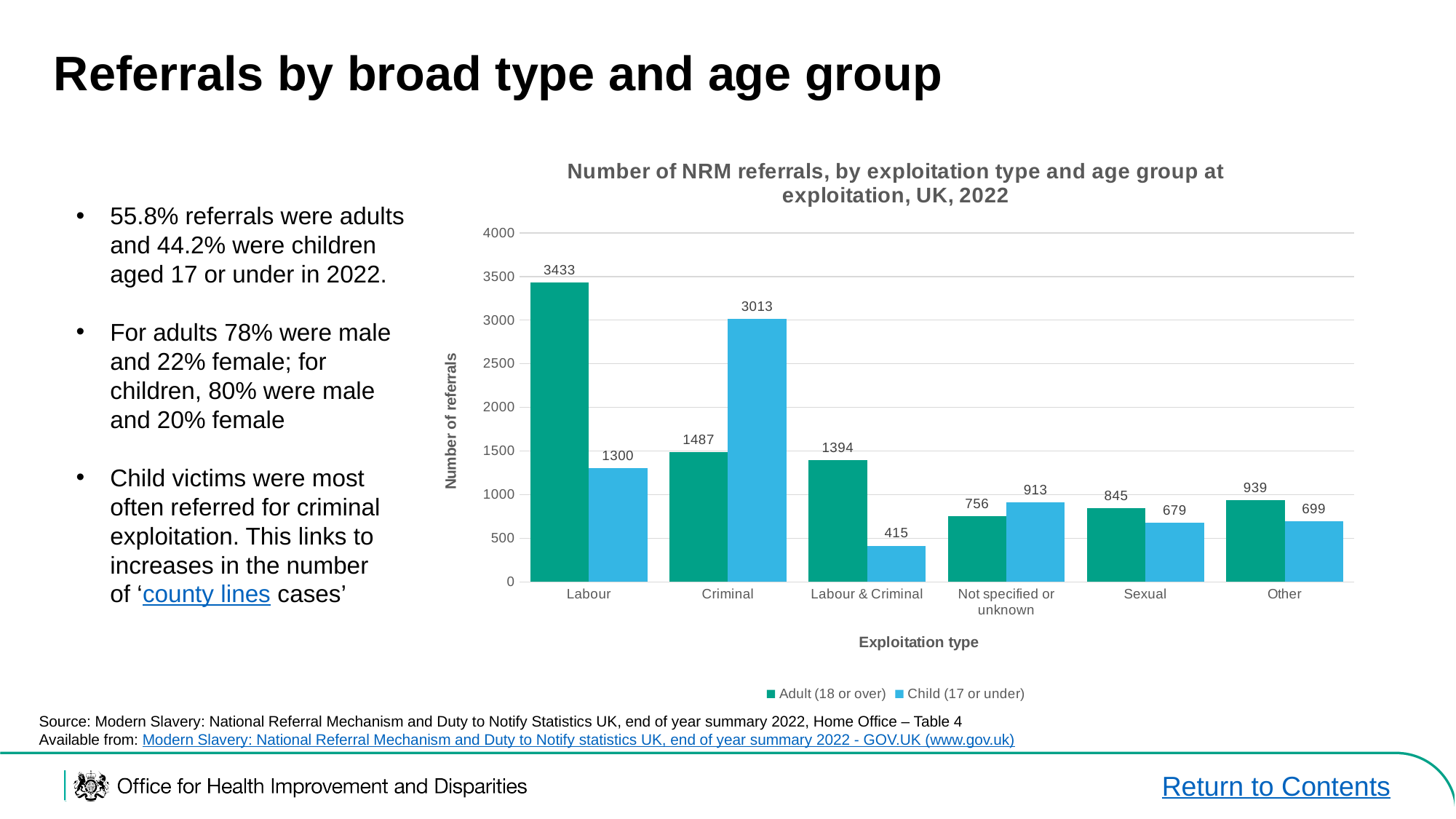
How many series does the legend list? 2 What is the label of the y axis? Number of referrals Which is larger for Sexual exploitation: Adult (18 or over) or Child (17 or under) referrals? Adult (18 or over) Is the number of Child (17 or under) referrals for Criminal exploitation greater or less than 2500? greater Which exploitation type has the highest number of Adult (18 or over) referrals? Labour What is the number of Adult (18 or over) referrals for Labour exploitation? 3433 What kind of chart is shown on the slide? Bar chart How many exploitation types are shown on the x axis? 6 What is the number of Child (17 or under) referrals for Labour & Criminal exploitation? 415 Which exploitation type has the lowest number of Child (17 or under) referrals? Labour & Criminal What is the difference between Adult and Child referrals for Labour exploitation? 2133 What is the number of Child (17 or under) referrals for Criminal exploitation? 3013